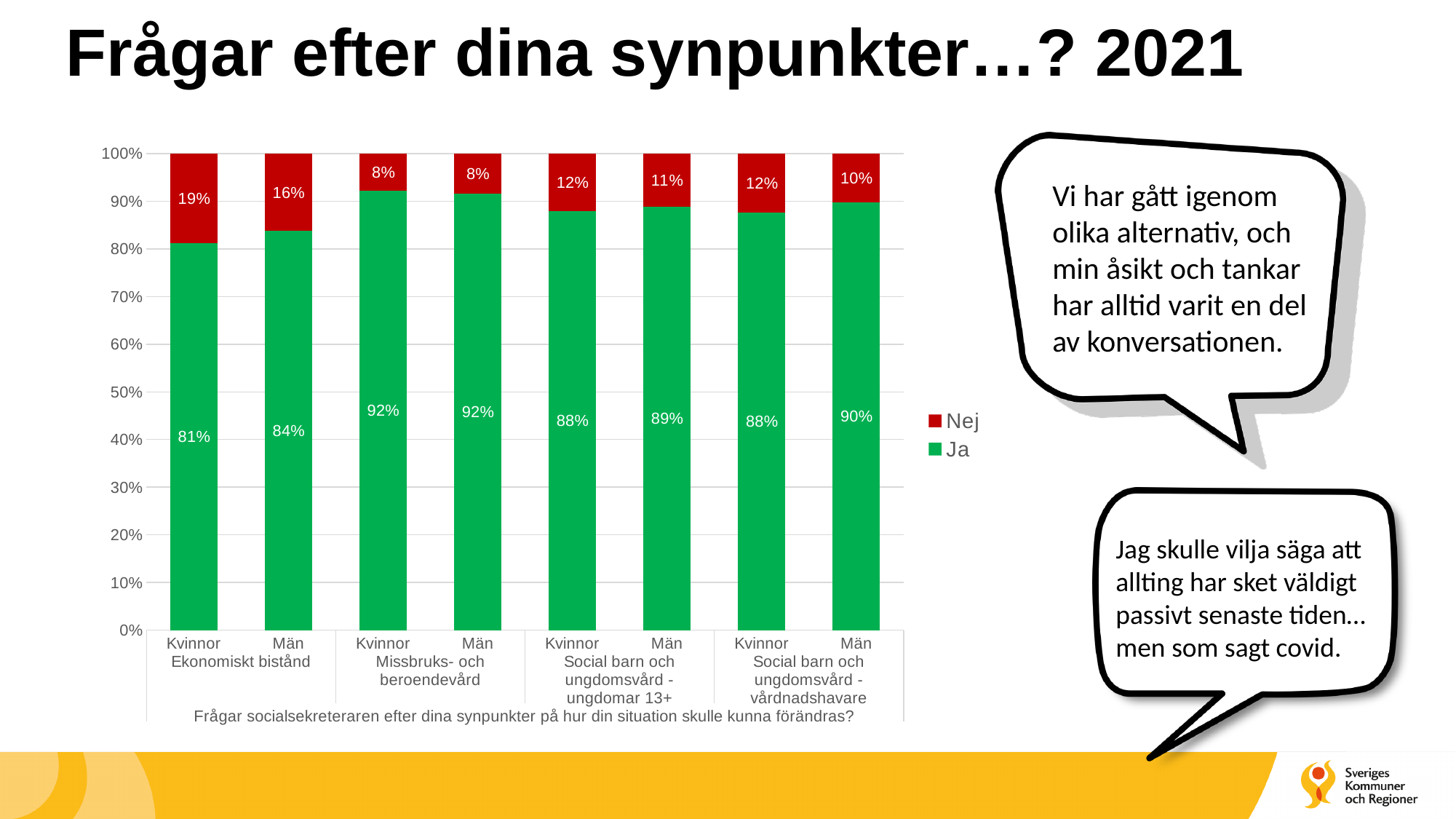
What are the two legend entries in the chart? Nej and Ja What is the Nej share for Män in Missbruks- och beroendevård? 8% What kind of chart is shown on the slide? Stacked bar chart How many bars are shown in the chart? 8 In Social barn och ungdomsvård - vårdnadshavare, who has the larger Ja share, Kvinnor or Män? Män Which group has the highest Nej share? Kvinnor, Ekonomiskt bistånd (19%) Which group has the lowest Ja share? Kvinnor, Ekonomiskt bistånd (81%) What is the difference in the Nej share between Kvinnor and Män in Ekonomiskt bistånd? 3 percentage points Is the Ja value for Kvinnor in Ekonomiskt bistånd greater or less than 90%? less What is the Ja value for Män in Social barn och ungdomsvård - vårdnadshavare? 90% What percentage of Kvinnor in Ekonomiskt bistånd answered Ja? 81% How many series does the legend list? 2